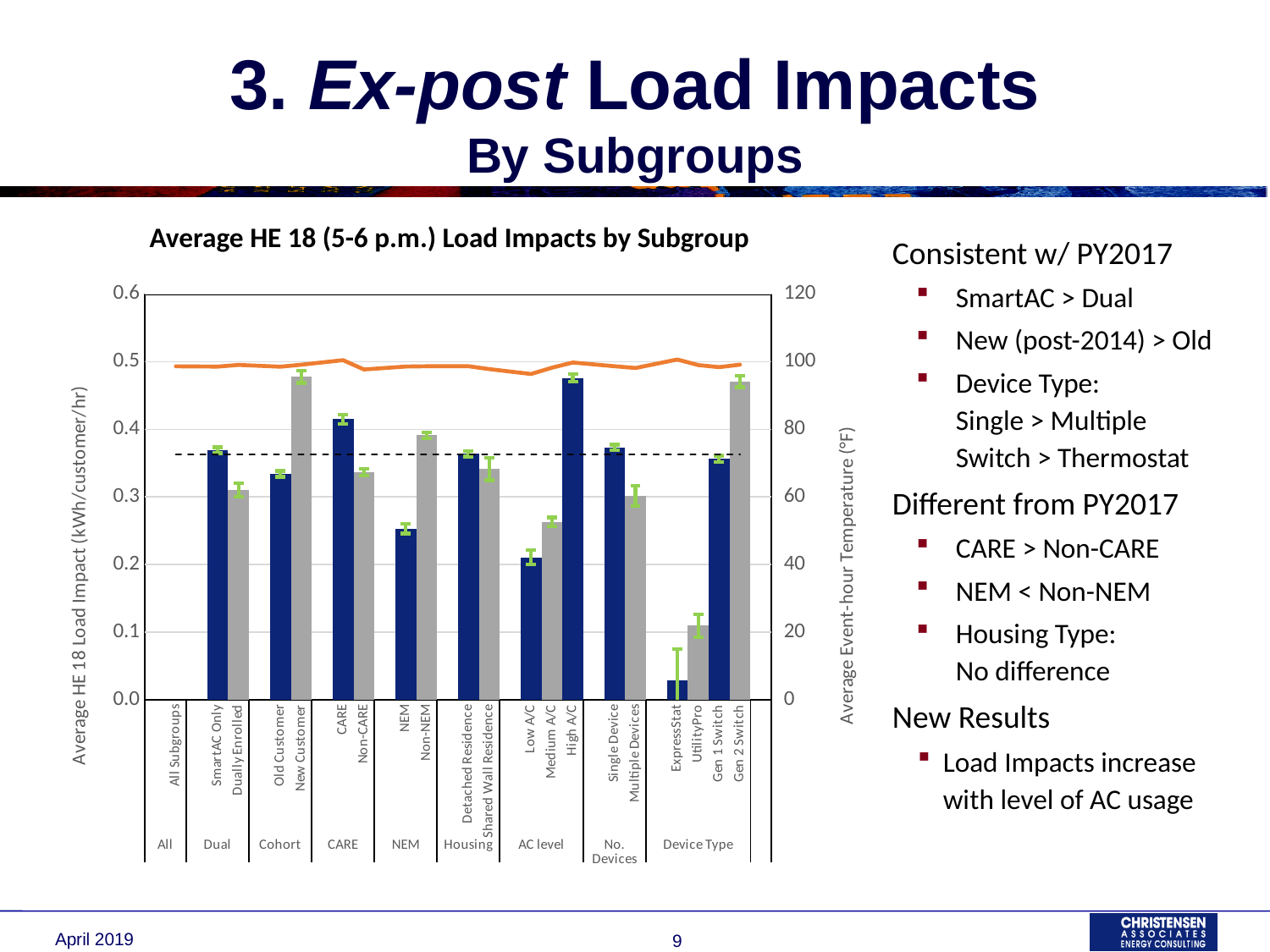
Which subgroup has the lowest average HE 18 load impact? ExpressStat Which has the larger load impact, NEM or Non-NEM? Non-NEM What type of chart is used to show the load impacts by subgroup? Bar chart How many subgroup categories (e.g., All, Dual, Cohort) are labeled along the bottom of the x axis? 9 What is the title of the chart? Average HE 18 (5-6 p.m.) Load Impacts by Subgroup Which has the larger load impact, CARE or Non-CARE? CARE What is the label of the right-hand vertical axis? Average Event-hour Temperature (°F) Is the load impact for UtilityPro greater or less than 0.2 kWh/customer/hr? less Is the load impact for Low A/C greater or less than 0.3 kWh/customer/hr? less Is the load impact for New Customer greater or less than 0.4 kWh/customer/hr? greater Which has the larger load impact, Low A/C or High A/C? High A/C